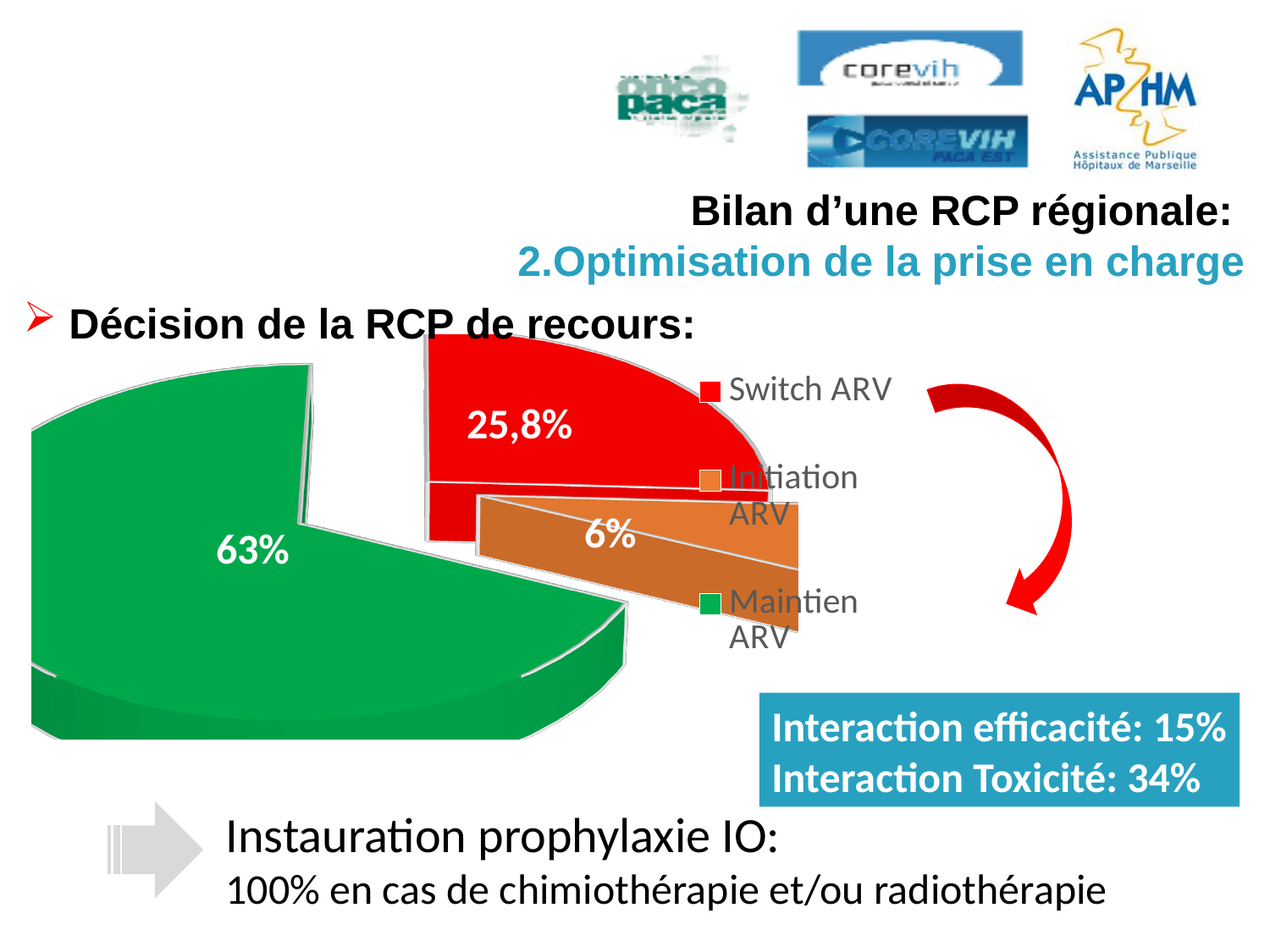
Which category has the smallest slice of the pie? Initiation ARV How many slices does the pie chart have? 3 What percentage is shown for Initiation ARV? 6% Which category has the largest slice of the pie? Maintien ARV What colour is the Switch ARV slice? red What kind of chart is shown on the slide? pie chart What percentage is shown for Maintien ARV? 63% Which is larger, the slice for Switch ARV or the slice for Initiation ARV? Switch ARV What percentage is shown for Switch ARV? 25,8% What colour is the Maintien ARV slice? green How many entries does the legend list? 3